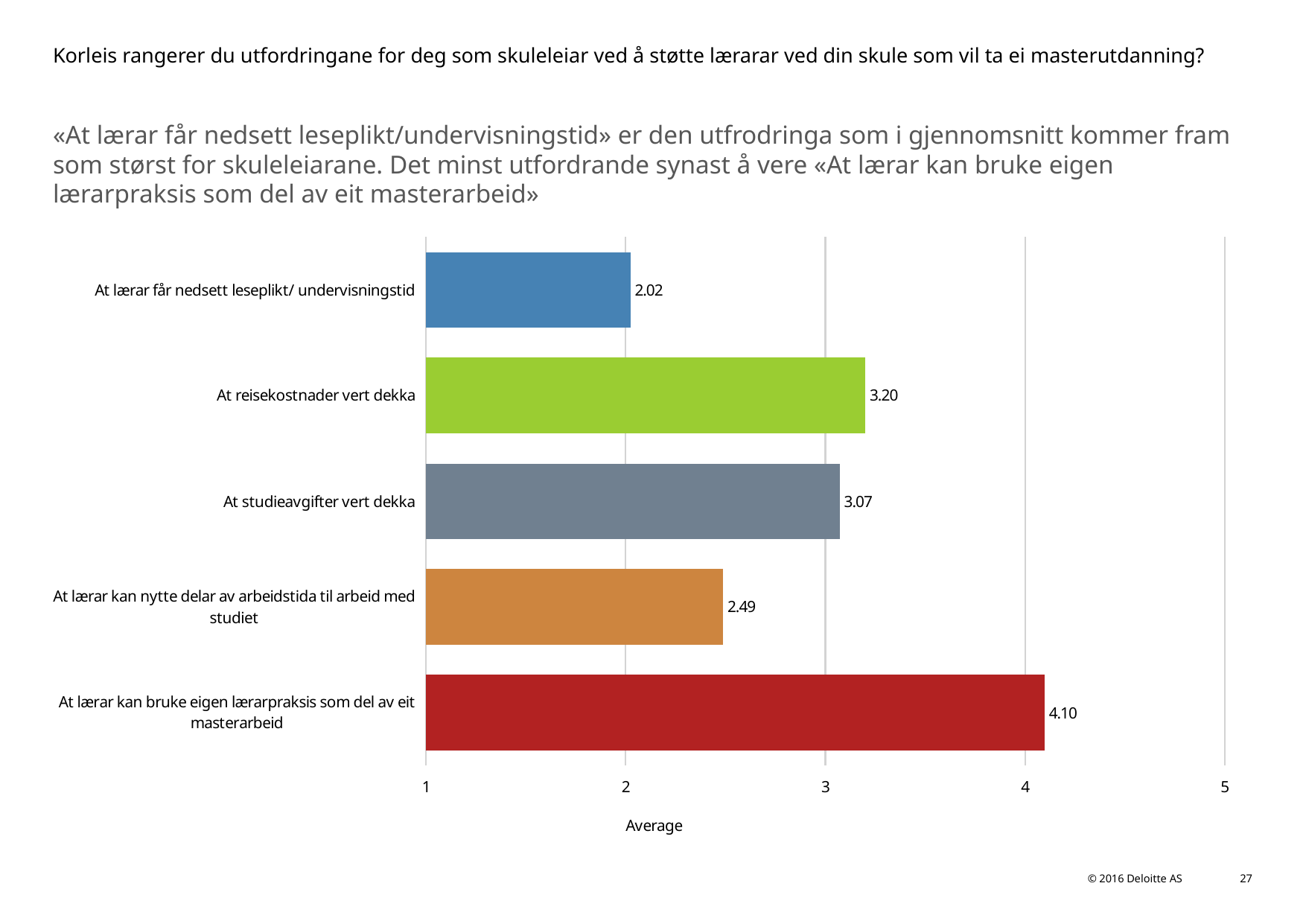
What is the difference between the highest and lowest average values shown? 2.08 Is the value for "At lærar kan bruke eigen lærarpraksis som del av eit masterarbeid" greater or less than 4? greater What is the difference between the average values for "At reisekostnader vert dekka" and "At studieavgifter vert dekka"? 0.13 What is the average value for "At lærar kan nytte delar av arbeidstida til arbeid med studiet"? 2.49 What is the average value for "At reisekostnader vert dekka"? 3.20 How many categories are shown in the chart? 5 What is the label of the horizontal axis? Average Which category has the highest average value? At lærar kan bruke eigen lærarpraksis som del av eit masterarbeid Which has a larger average value: "At studieavgifter vert dekka" or "At lærar kan nytte delar av arbeidstida til arbeid med studiet"? At studieavgifter vert dekka Which category has the lowest average value? At lærar får nedsett leseplikt/ undervisningstid What kind of chart is shown on the slide? Bar chart What is the average value for "At lærar får nedsett leseplikt/ undervisningstid"? 2.02